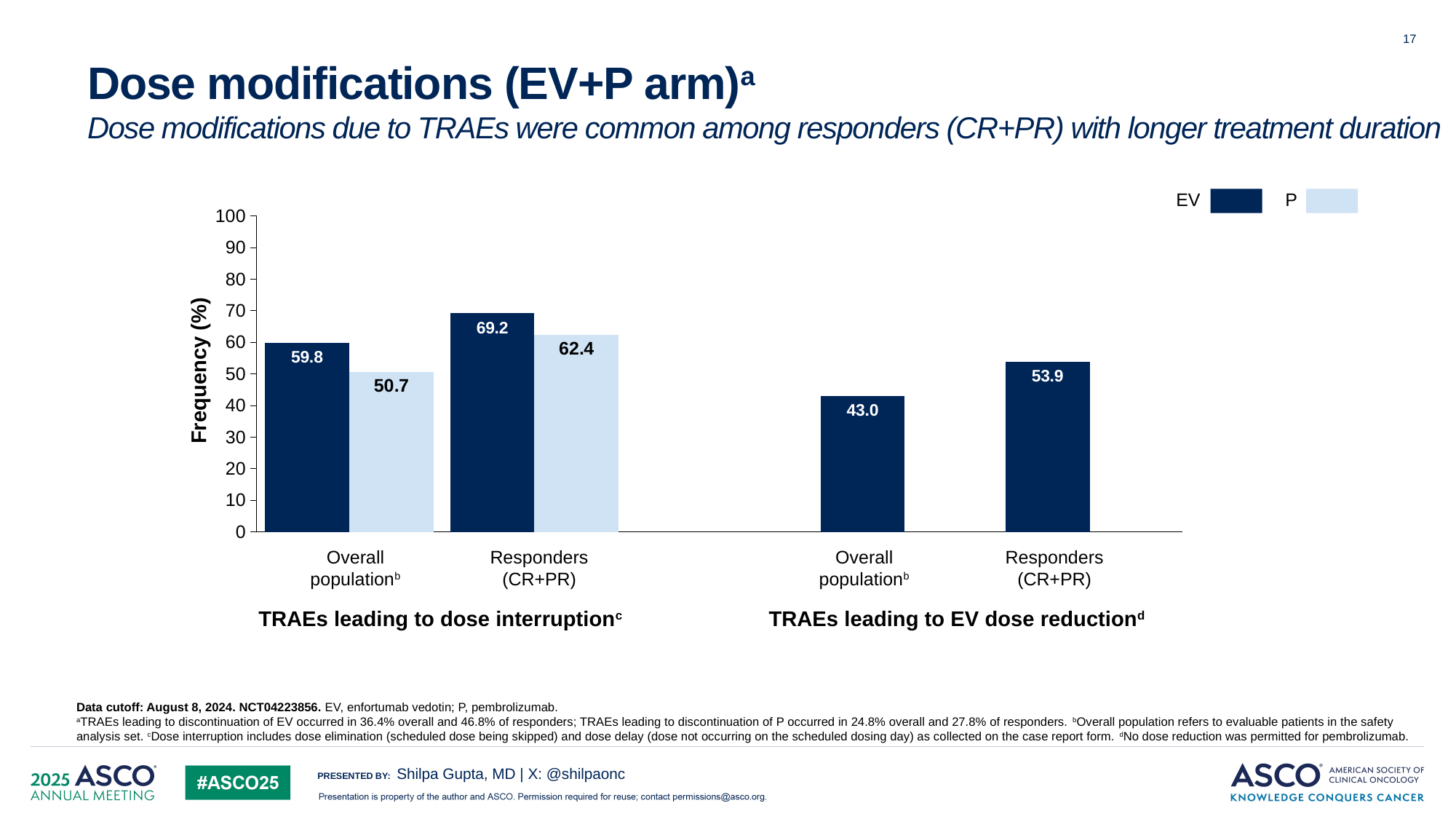
What kind of chart is shown on the slide? bar chart What is the EV value for the Overall population under TRAEs leading to dose interruption? 59.8 How many series does the legend list? 2 What is the value for the Overall population under TRAEs leading to EV dose reduction? 43.0 Which bar has the highest value on the chart? EV, Responders (CR+PR), TRAEs leading to dose interruption What is the label of the y axis? Frequency (%) What is the P value for Responders (CR+PR) under TRAEs leading to dose interruption? 62.4 What is the difference between Responders (CR+PR) and the Overall population under TRAEs leading to EV dose reduction? 10.9 Under TRAEs leading to dose interruption, is the EV value for Responders (CR+PR) larger or smaller than the P value for Responders (CR+PR)? larger What is the difference between the EV and P values for the Overall population under TRAEs leading to dose interruption? 9.1 Which bar has the lowest value on the chart? Overall population, TRAEs leading to EV dose reduction What is the value for Responders (CR+PR) under TRAEs leading to EV dose reduction? 53.9